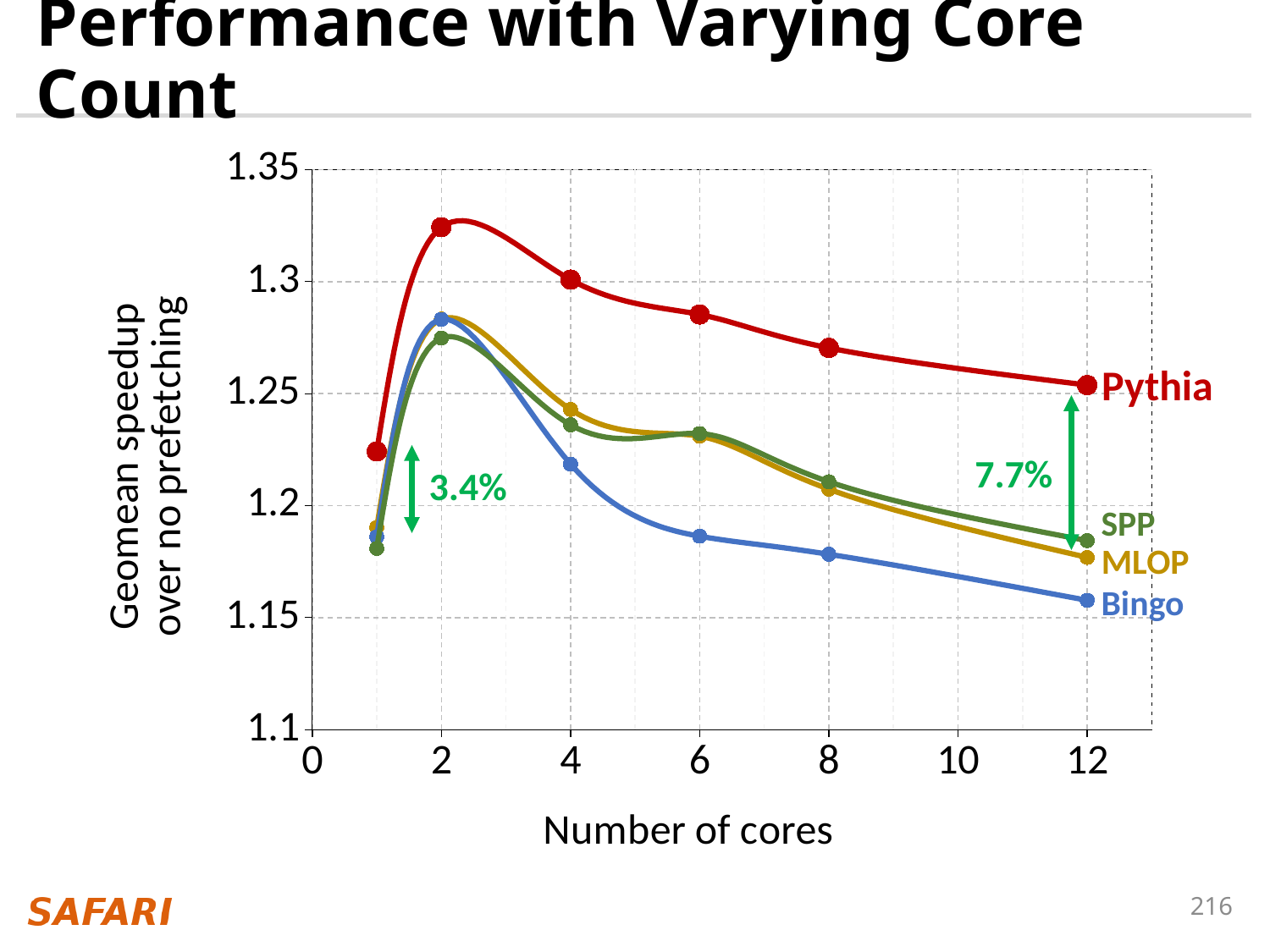
How many series (prefetchers) are plotted on the chart? 4 Which series has the lowest geomean speedup at 12 cores? Bingo Does the geomean speedup for Pythia rise or fall as the number of cores increases from 2 to 12? fall Is the geomean speedup for Pythia at 1 core greater or less than 1.2? greater Is the geomean speedup for Pythia at 2 cores greater or less than 1.3? greater How many core-count data points are plotted for each series? 6 What percentage improvement is annotated between Pythia and SPP at 12 cores? 7.7% Is the geomean speedup for Bingo at 12 cores greater or less than 1.2? less What kind of chart is shown on the slide? line chart At which number of cores does Pythia reach its highest geomean speedup? 2 At 8 cores, which series has the larger geomean speedup, Pythia or Bingo? Pythia Which series has the highest geomean speedup at 12 cores? Pythia